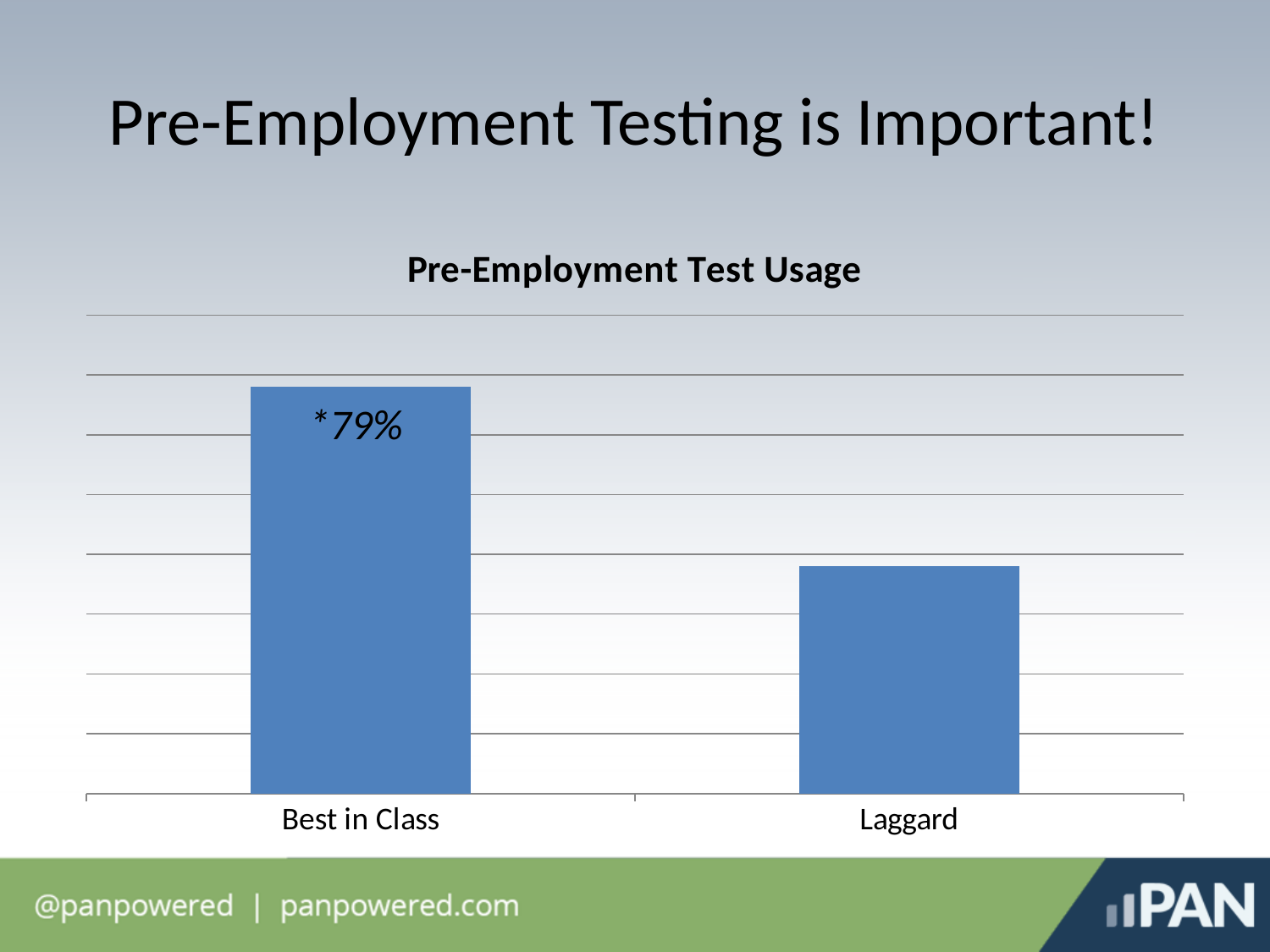
How many categories are plotted in the Pre-Employment Test Usage chart? 2 What colour are the bars in the Pre-Employment Test Usage chart? Blue Which category has the lowest bar in the Pre-Employment Test Usage chart? Laggard Do the bars rise or fall from Best in Class to Laggard in the Pre-Employment Test Usage chart? Fall Which category has the highest bar in the Pre-Employment Test Usage chart? Best in Class What is the title of the chart on the slide? Pre-Employment Test Usage What kind of chart is used to show Pre-Employment Test Usage? Bar chart Which is larger in the Pre-Employment Test Usage chart, the value for Best in Class or the value for Laggard? Best in Class